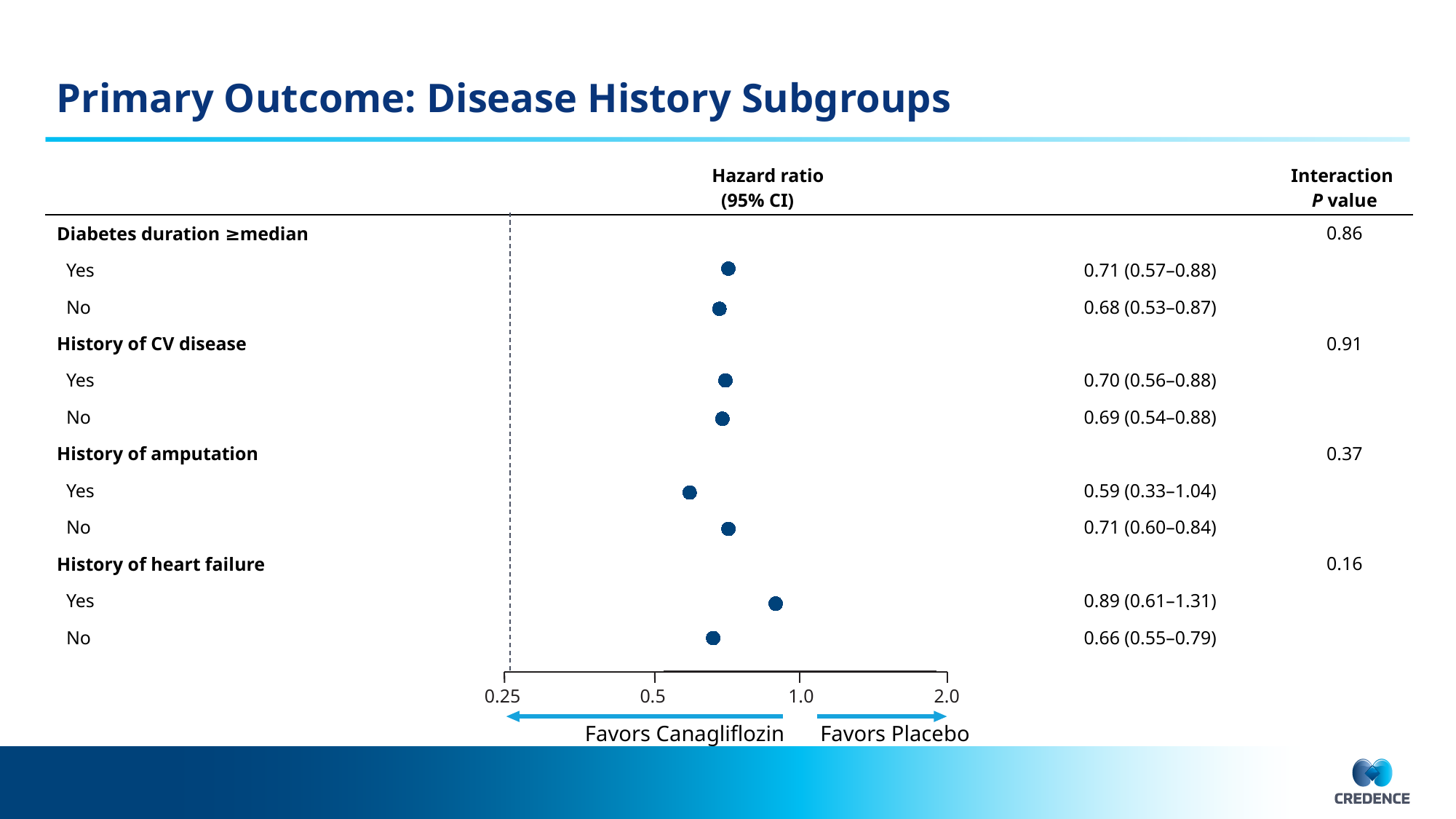
What is the hazard ratio and 95% CI for patients with a history of amputation (Yes)? 0.59 (0.33–1.04) Which interaction P value is the lowest among the four subgroups? 0.16 Which has the larger hazard ratio: History of heart failure Yes or History of heart failure No? History of heart failure Yes Which subgroup has the highest hazard ratio? History of heart failure, Yes What kind of chart is shown on the slide? Forest plot Is the hazard ratio for History of heart failure (Yes) greater or less than 1.0? less How many hazard ratio points are plotted on the chart? 8 What is the hazard ratio for patients with diabetes duration ≥median (No)? 0.68 Which subgroup has the lowest hazard ratio? History of amputation, Yes What is the interaction P value for the History of heart failure subgroup? 0.16 What is the difference between the hazard ratios for History of amputation No and History of amputation Yes? 0.12 What is the hazard ratio for patients with a history of heart failure (Yes)? 0.89